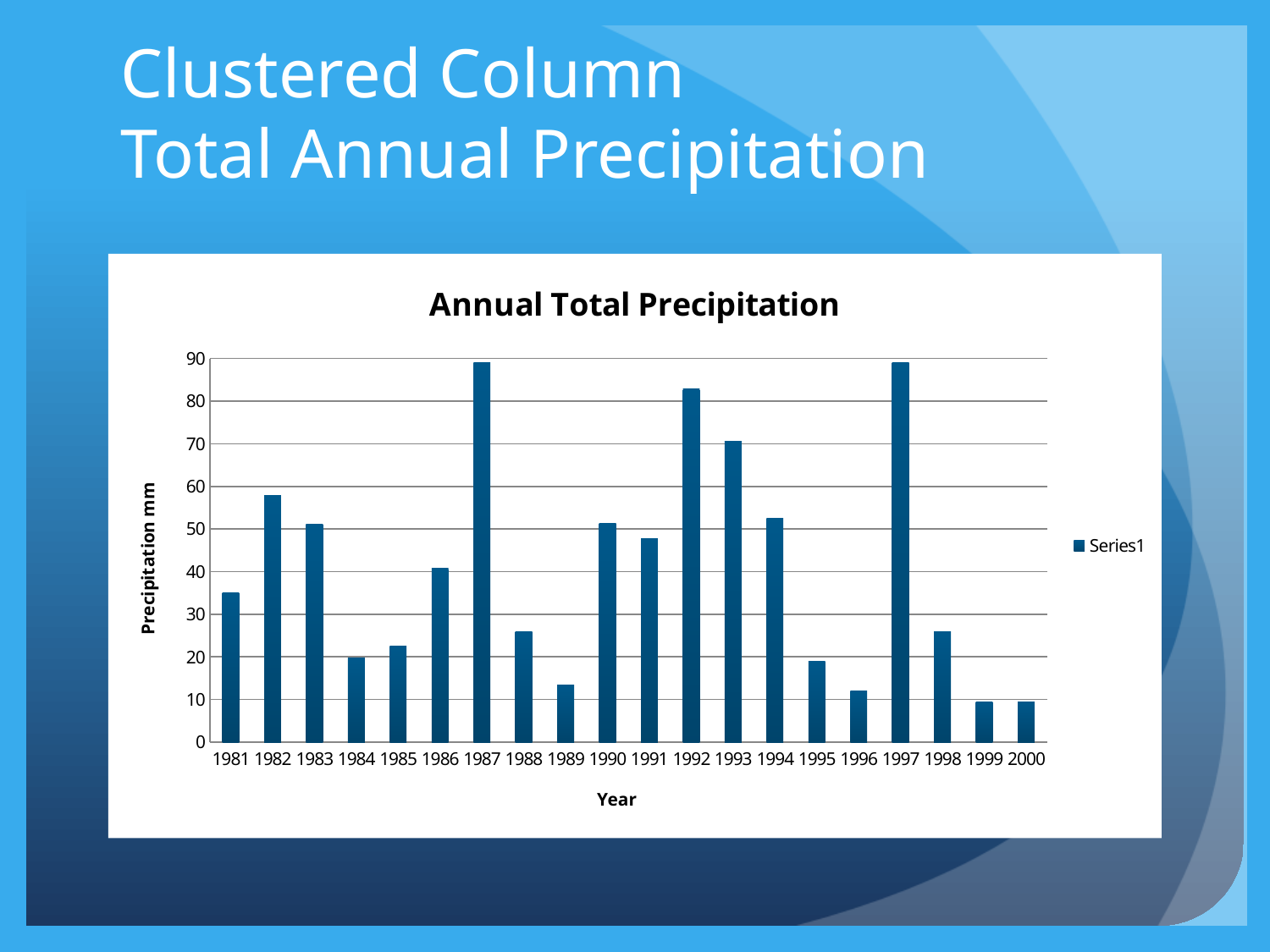
Which year has the higher precipitation, 1982 or 1983? 1982 Is the value for 1987 greater or less than 80? greater What kind of chart is shown on the slide? bar chart Is the value for 1989 greater or less than 10? greater Is the value for 1998 greater or less than 20? greater What is the label on the vertical axis of the chart? Precipitation mm How many years are plotted on the x axis of the chart? 20 What is the title of the chart? Annual Total Precipitation How many series does the chart legend list? 1 Which year has the higher precipitation, 1992 or 1993? 1992